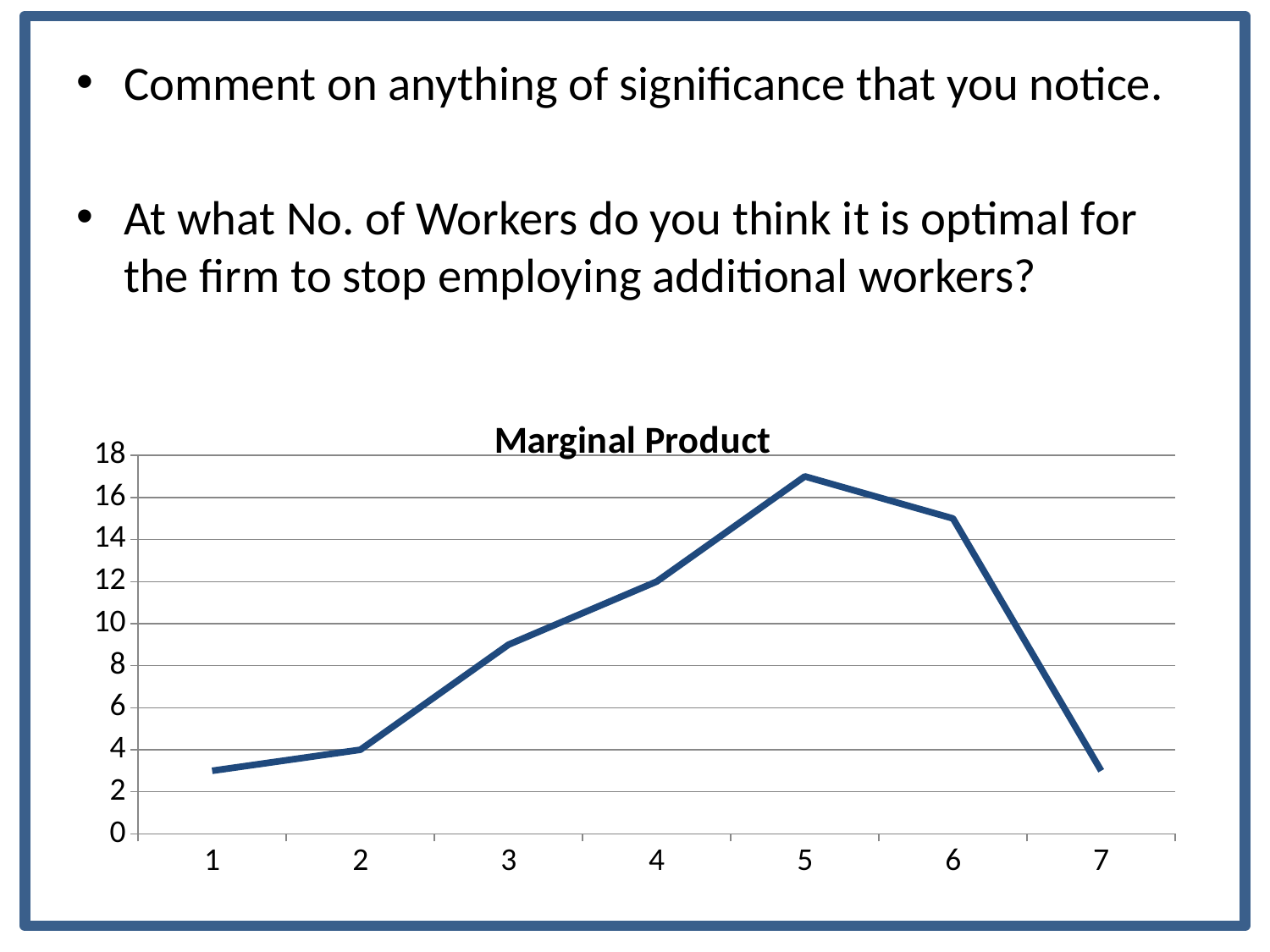
Is the Marginal Product value at 7 workers greater or less than 4? less What is the Marginal Product value at 4 workers? 12 What is the title of the chart? Marginal Product How many points are plotted on the Marginal Product line? 7 Is the Marginal Product value at 6 workers greater or less than 14? greater Does the Marginal Product rise or fall between 5 and 7 workers? fall Is the Marginal Product value at 5 workers greater or less than 16? greater What kind of chart is shown on the slide? line chart Which has the larger Marginal Product, 5 workers or 6 workers? 5 workers What is the Marginal Product value at 2 workers? 4 At which number of workers is the Marginal Product highest? 5